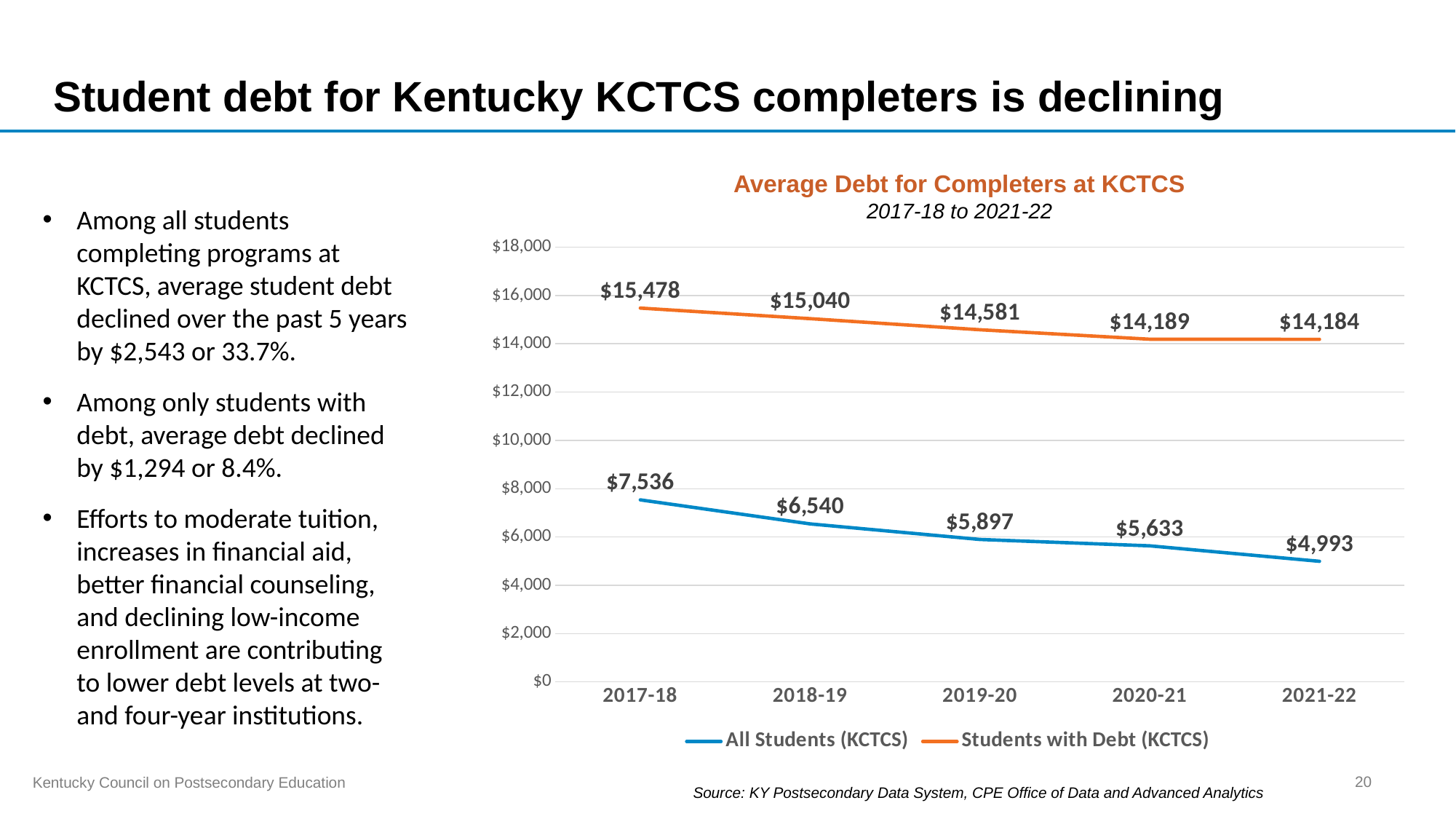
What kind of chart is shown on the slide? line chart How many series does the legend list? 2 In which year is the average debt for Students with Debt (KCTCS) highest? 2017-18 What is the difference between the Students with Debt (KCTCS) value and the All Students (KCTCS) value in 2020-21? $8,556 What is the average debt for All Students (KCTCS) in 2019-20? $5,897 What is the average debt for All Students (KCTCS) in 2017-18? $7,536 Does the average debt for All Students (KCTCS) rise or fall from 2017-18 to 2021-22? fall How many years are shown on the x axis? 5 What is the average debt for Students with Debt (KCTCS) in 2021-22? $14,184 In which year is the average debt for All Students (KCTCS) lowest? 2021-22 Which is larger: the All Students (KCTCS) value in 2018-19 or in 2020-21? 2018-19 Is the value for Students with Debt (KCTCS) in 2019-20 greater or less than $14,000? greater